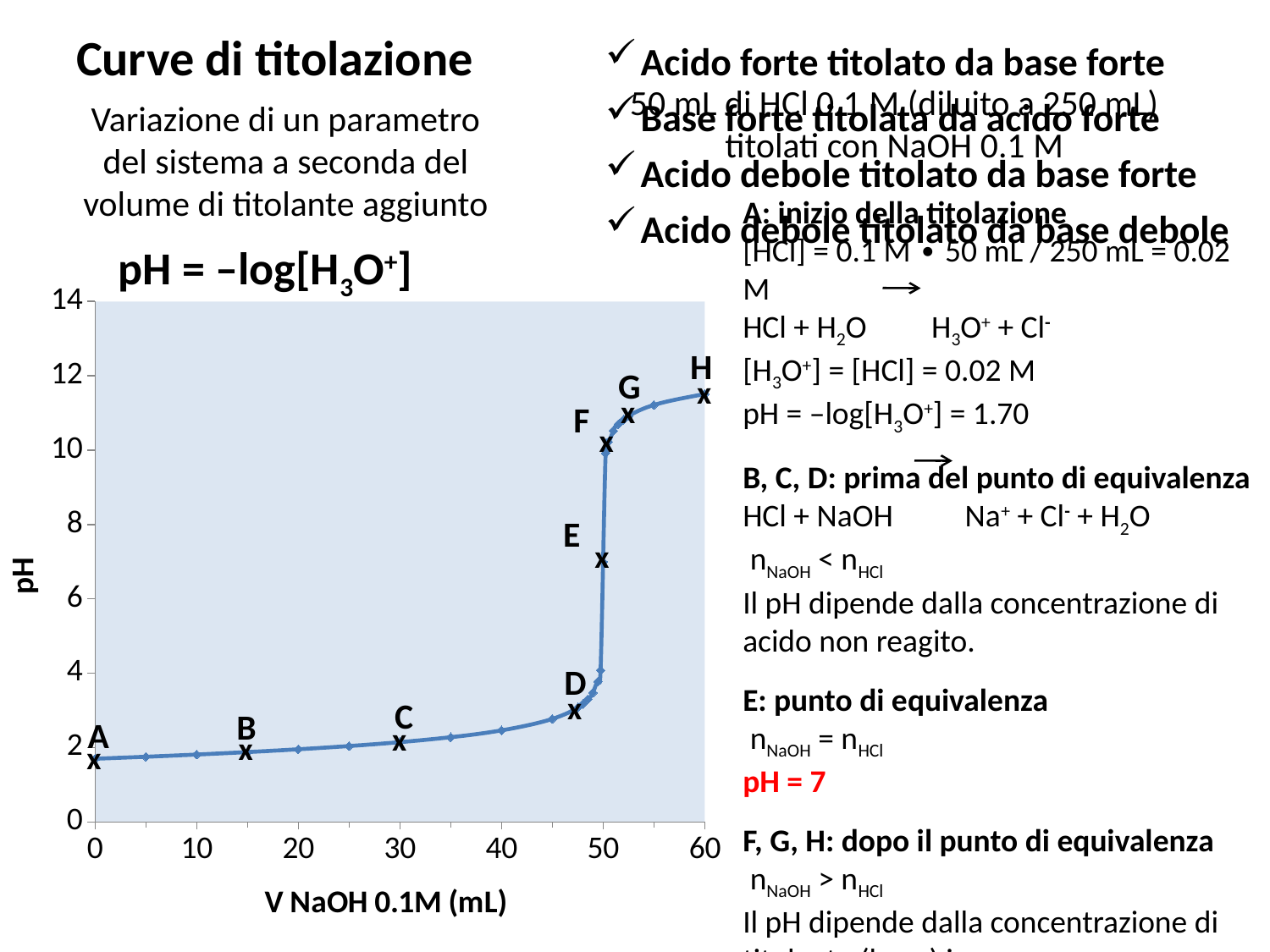
Is the pH at point F greater or less than 8? greater What is the label of the y axis of the chart? pH How many labeled points (letters) are marked on the titration curve? 8 Does the pH rise or fall as the volume of NaOH increases along the x axis? rise Which labeled point has the highest pH on the curve? H Is the pH at point A greater or less than 4? less Which has the higher pH, point G or point D? G Which labeled point has the lowest pH on the curve? A Is the pH at point C greater or less than 4? less What is the label of the x axis of the chart? V NaOH 0.1M (mL) What kind of chart is shown on the slide? line chart